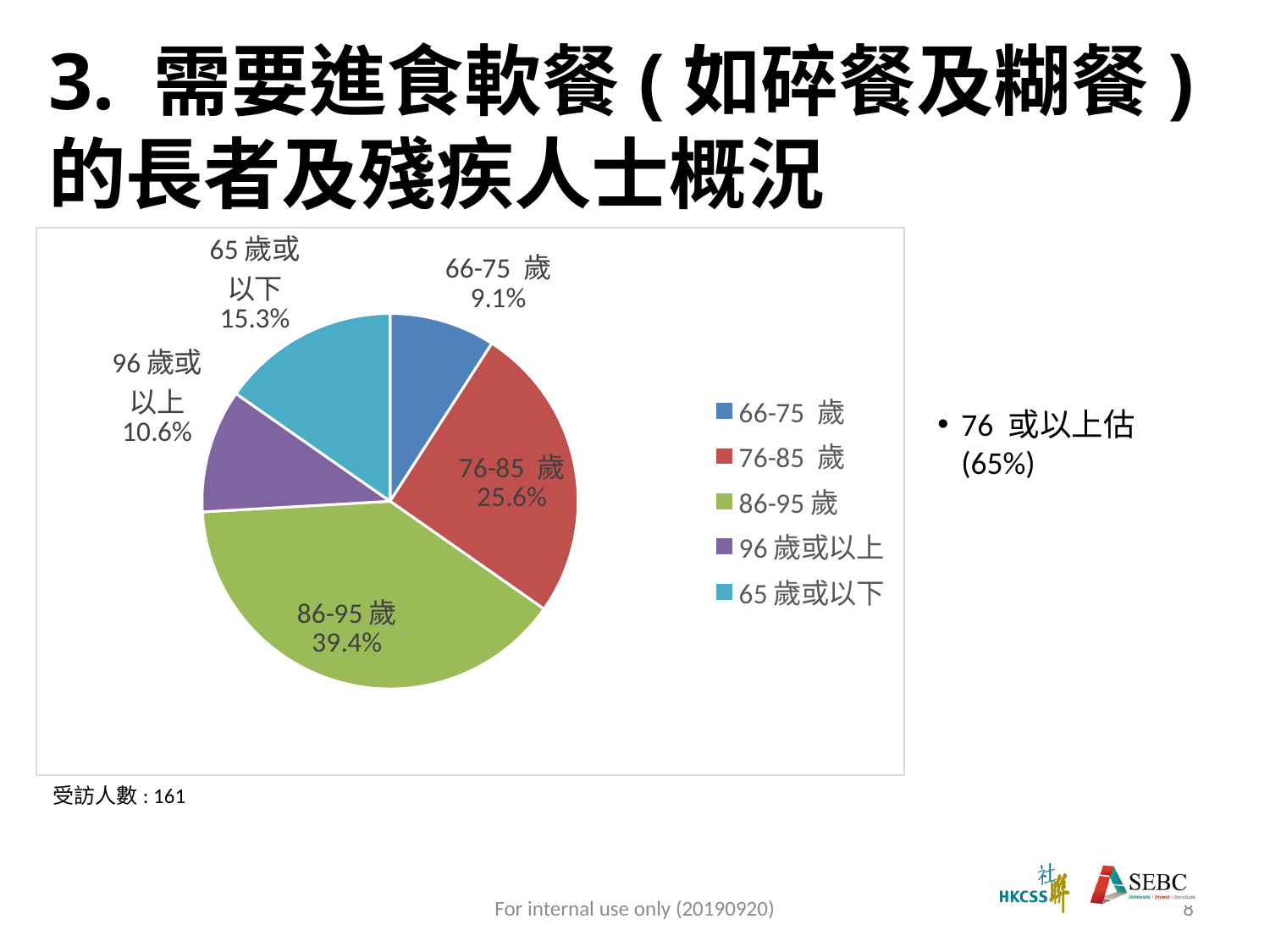
What is the difference between the 86-95 歲 slice and the 76-85 歲 slice? 13.8% How many slices does the pie chart have? 5 Which age group has the largest slice of the pie? 86-95 歲 What is the value shown for the 66-75 歲 slice? 9.1% Which is larger, the 65 歲或以下 slice or the 96 歲或以上 slice? 65 歲或以下 What is the value shown for the 96 歲或以上 slice? 10.6% How many entries does the legend list? 5 What share of the pie does the 86-95 歲 slice represent? 39.4% What kind of chart is shown on the slide? Pie chart Which age group has the smallest slice of the pie? 66-75 歲 What is the value shown for the 65 歲或以下 slice? 15.3% What colour is the 76-85 歲 slice? Red